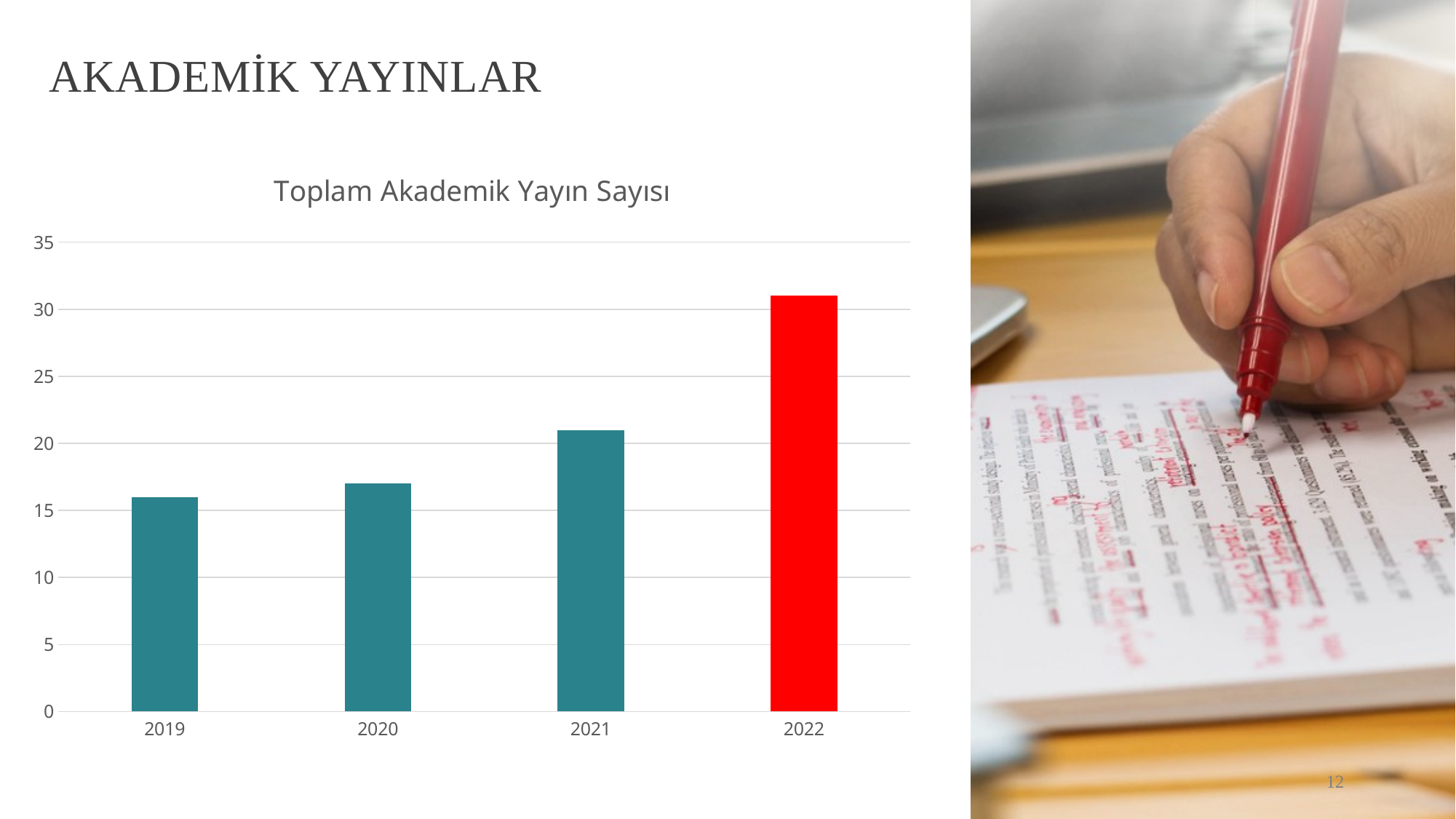
Is the value for 2020 greater or less than 20? less Which year's bar is coloured red in the chart? 2022 Which is larger, the value for 2021 or the value for 2020? 2021 Do the values rise or fall from 2019 to 2022? rise How many years are shown on the x axis of the chart? 4 What is the title of the chart? Toplam Akademik Yayın Sayısı Is the value for 2019 greater or less than 15? greater Which year has the lowest value in the chart? 2019 Is the value for 2021 greater or less than 20? greater What type of chart is shown on the slide? bar chart Which year has the highest value in the chart? 2022